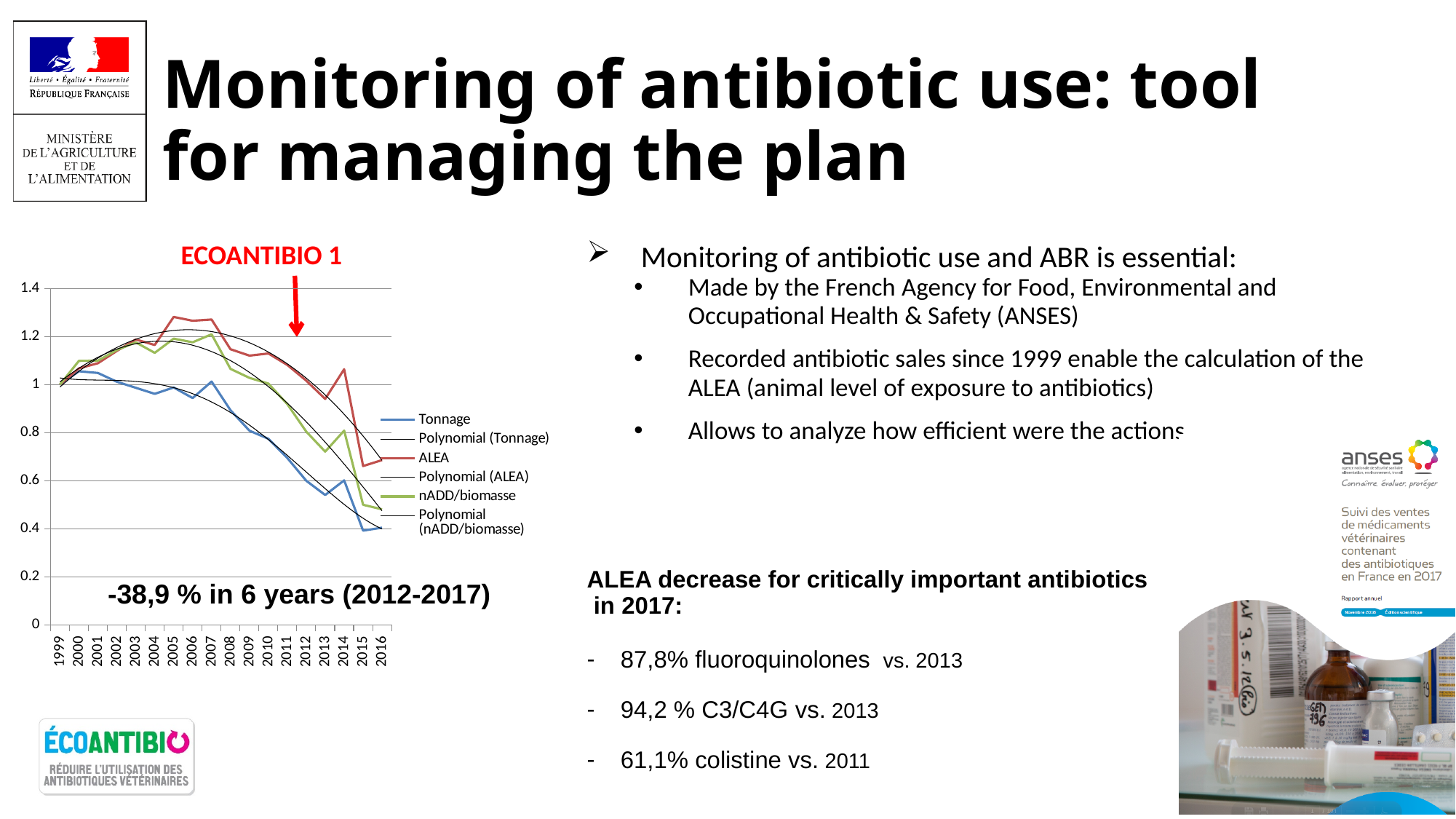
Is the value of the nADD/biomasse series in 2016 greater or less than 0.6? less How many entries does the legend of the chart list? 6 What colour is the ALEA line in the chart? red Does the Tonnage series rise or fall between 2007 and 2016? fall Is the value of the ALEA series in 2005 greater or less than 1.2? greater What is the first year shown on the x axis of the chart? 1999 Is the value of the Tonnage series in 2016 greater or less than 0.6? less How many years are shown along the x axis of the chart? 18 In 2014, which is larger: the ALEA value or the Tonnage value? ALEA What is the value of the ALEA series in 1999? 1 Which series has the highest value in 2016? ALEA What kind of chart is shown on the left of the slide? line chart